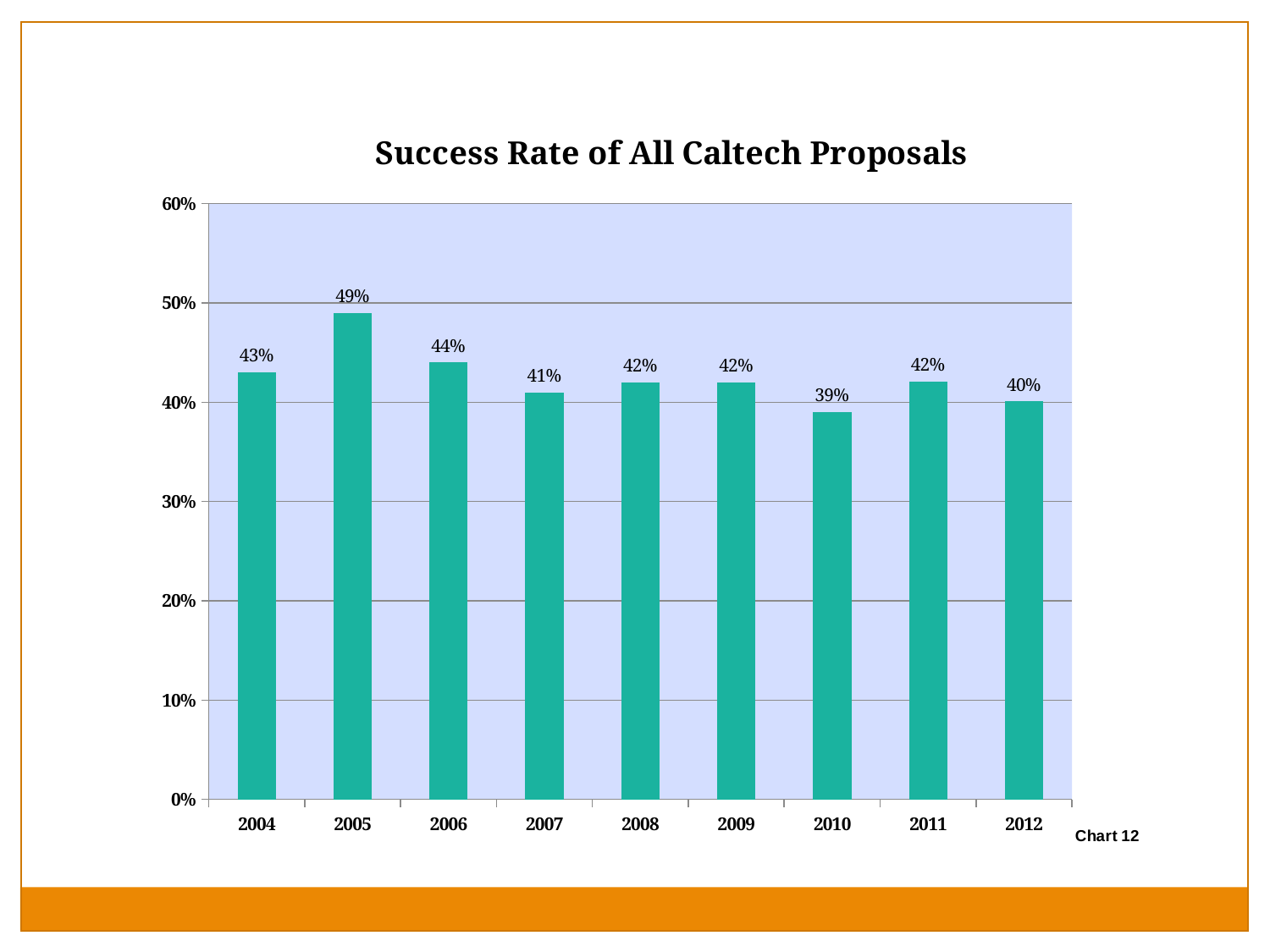
What is the success rate of all Caltech proposals in 2005? 49% What kind of chart is used to show the success rate of all Caltech proposals? Bar chart What is the title of the chart? Success Rate of All Caltech Proposals Is the success rate for 2010 greater or less than 40%? less How many years are shown on the x axis of the chart? 9 What is the difference between the success rate in 2005 and the success rate in 2010? 10% What is the difference between the success rate in 2006 and the success rate in 2007? 3% Which year has a higher success rate, 2004 or 2006? 2006 What is the success rate shown for 2012? 40% What is the success rate shown for 2010? 39% Which year has the highest success rate? 2005 Which year has the lowest success rate? 2010